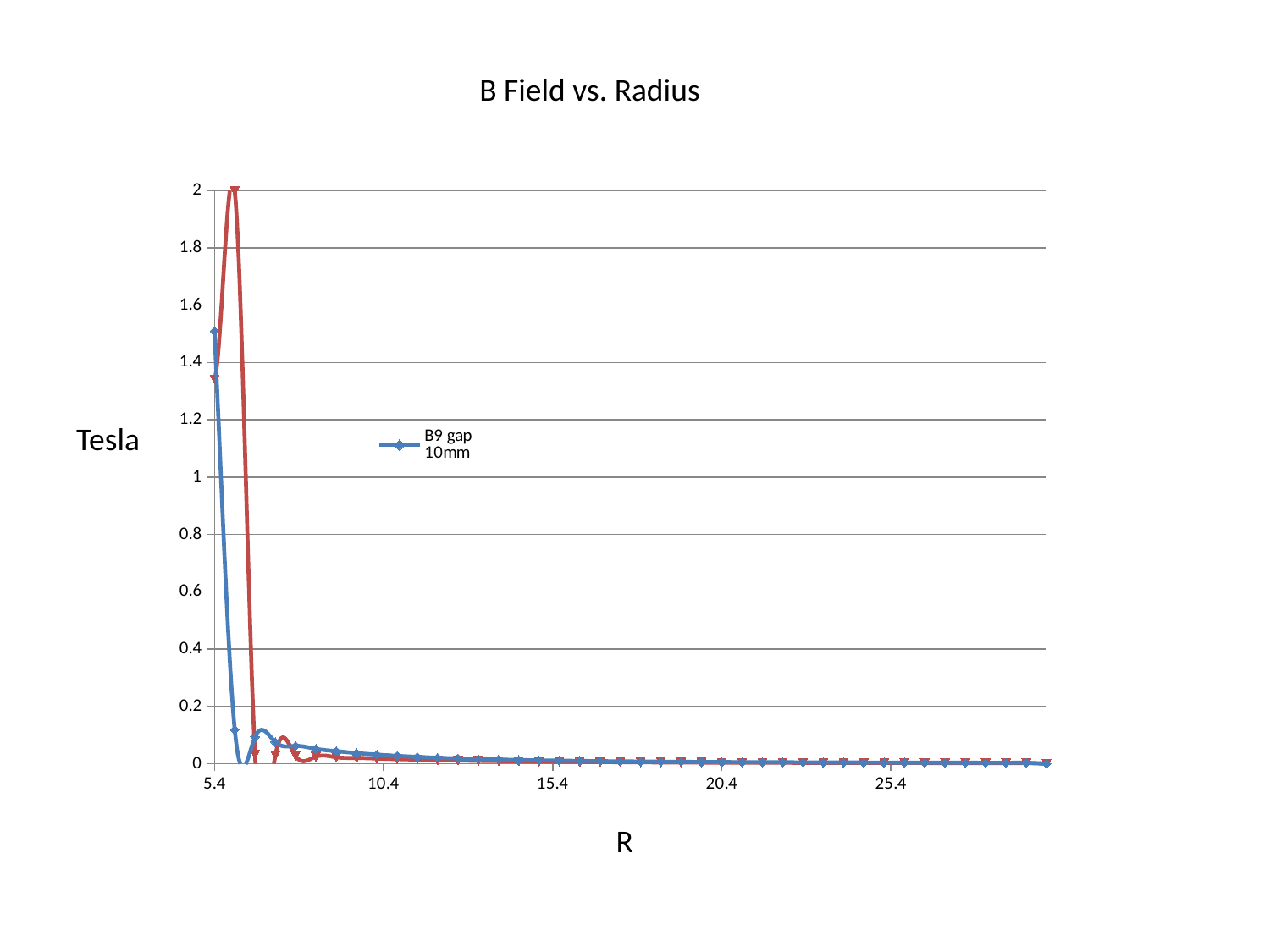
What is the highest value shown on the vertical axis? 2 Which series reaches the higher peak value, the blue series or the red series? the red series Is the peak value of the red series greater or less than 1.8? greater What is the title of the chart? B Field vs. Radius Is the value of the blue B9 gap 10mm series at R = 20.4 greater or less than 0.2? less What kind of chart is shown on the slide? line chart How many series does the chart's legend list? 1 Is the value of the blue B9 gap 10mm series at R = 5.4 greater or less than 1? greater What label is shown on the vertical axis of the chart? Tesla Overall, do the values of the blue B9 gap 10mm series rise or fall as R increases from 5.4 to the right end of the axis? fall